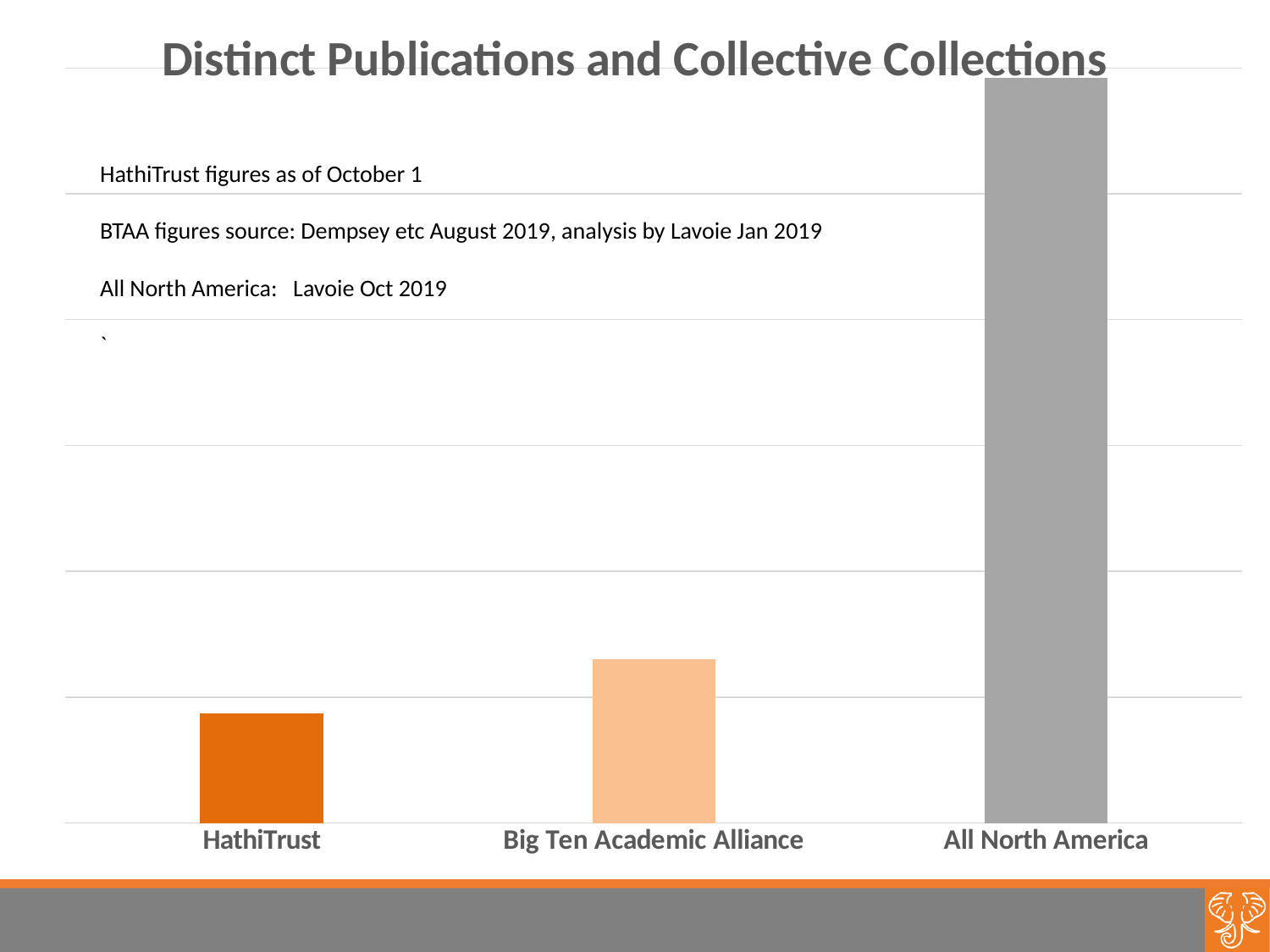
How many categories are plotted in the chart? 3 Which category has the highest bar in the chart? All North America Do the bar values rise or fall from left to right along the x axis? rise Which category has the lowest bar in the chart? HathiTrust What kind of chart is shown on the slide? bar chart Which is larger, the bar for HathiTrust or the bar for Big Ten Academic Alliance? Big Ten Academic Alliance Which is larger, the bar for Big Ten Academic Alliance or the bar for All North America? All North America What colour is the bar for All North America? grey What is the title of the chart? Distinct Publications and Collective Collections